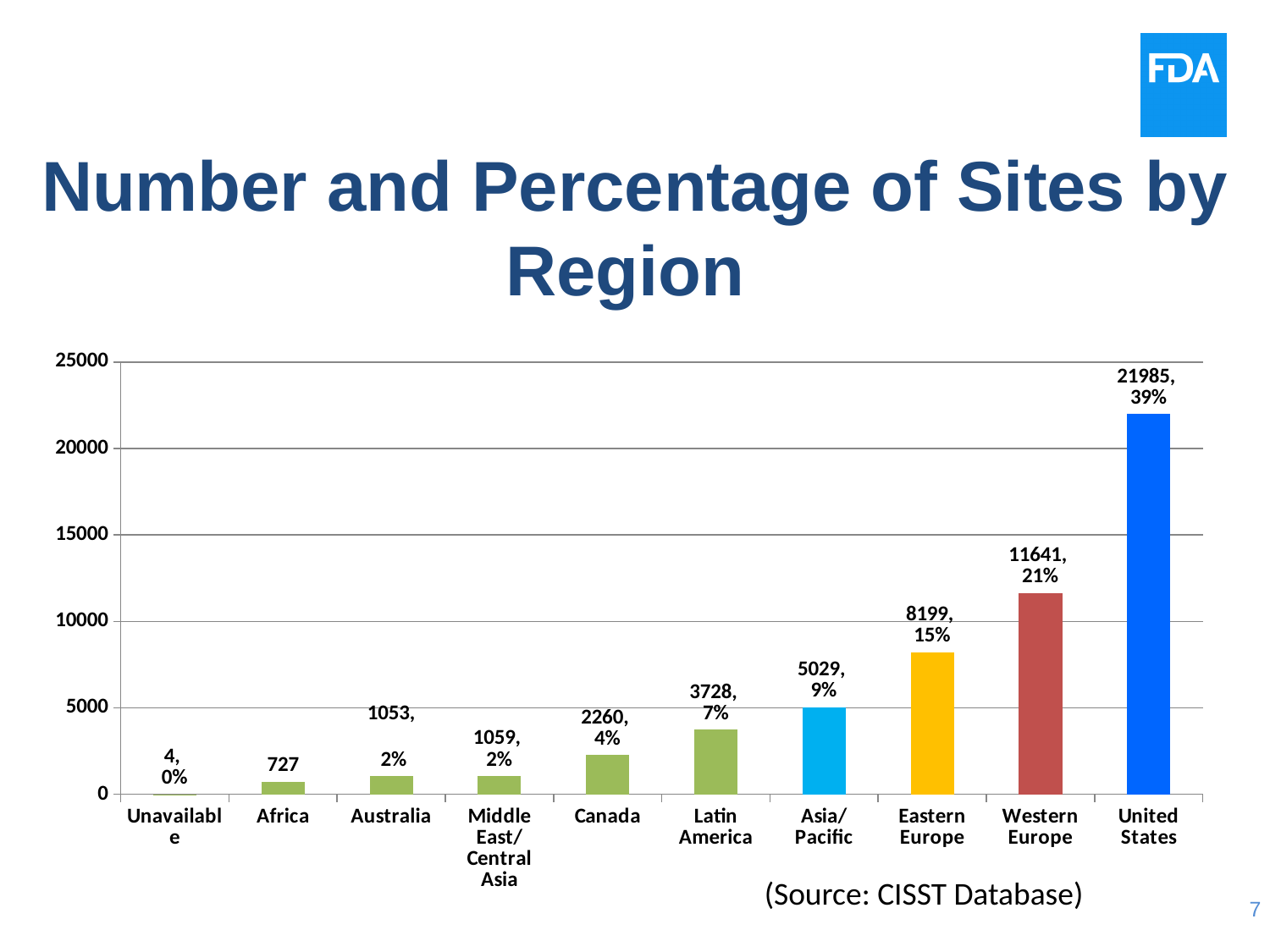
What percentage of sites is shown for Western Europe? 21% What is the difference in the number of sites between the United States and Western Europe? 10344 What is the number of sites for the United States? 21985 What kind of chart is shown on the slide? Bar chart How many regions are shown on the x axis? 10 Which region has the highest number of sites? United States Which has more sites, Canada or Latin America? Latin America Do the values rise or fall from left to right along the x axis? Rise Is the value for Asia/Pacific greater or less than 5000? greater What is the number of sites for Eastern Europe? 8199 What is the number of sites for Africa? 727 Which category has the lowest number of sites? Unavailable